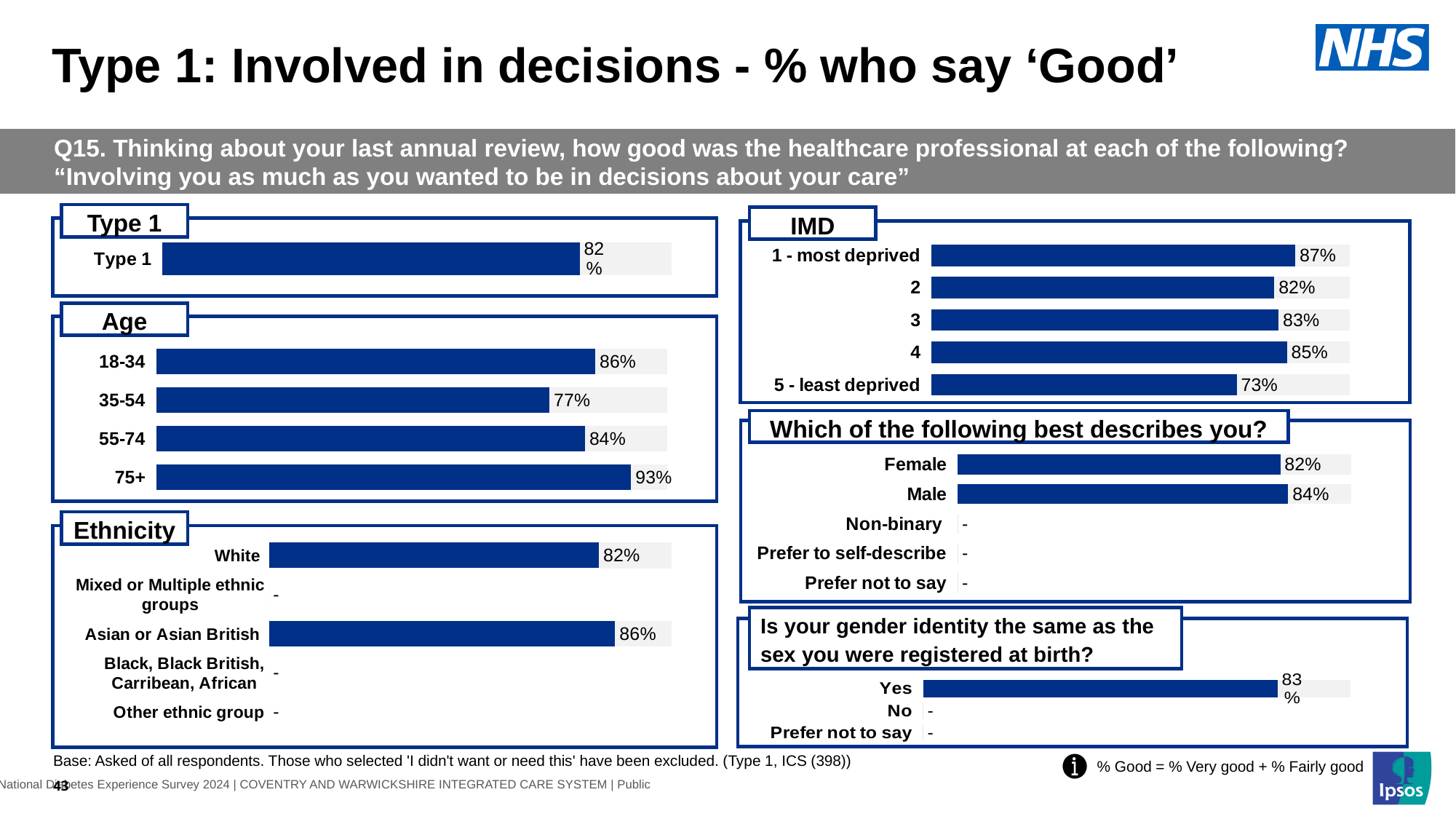
In the IMD chart, what is the value for 1 - most deprived? 87% In the Age chart, what is the value for the 75+ group? 93% In the Ethnicity chart, which is larger, the value for White or for Asian or Asian British? Asian or Asian British What kind of chart is used in the Age section? Bar chart In the 'Is your gender identity the same as the sex you were registered at birth?' chart, what is the value for Yes? 83% In the IMD chart, which category has the lowest value? 5 - least deprived In the IMD chart, what is the difference between the values for 4 and 5 - least deprived? 12 percentage points In the Age chart, what is the difference between the 75+ and 35-54 values? 16 percentage points In the Ethnicity chart, what is the value for Asian or Asian British? 86% In the 'Which of the following best describes you?' chart, what is the value for Male? 84% How many categories are listed in the IMD chart? 5 In the Age chart, which age group has the lowest value? 35-54